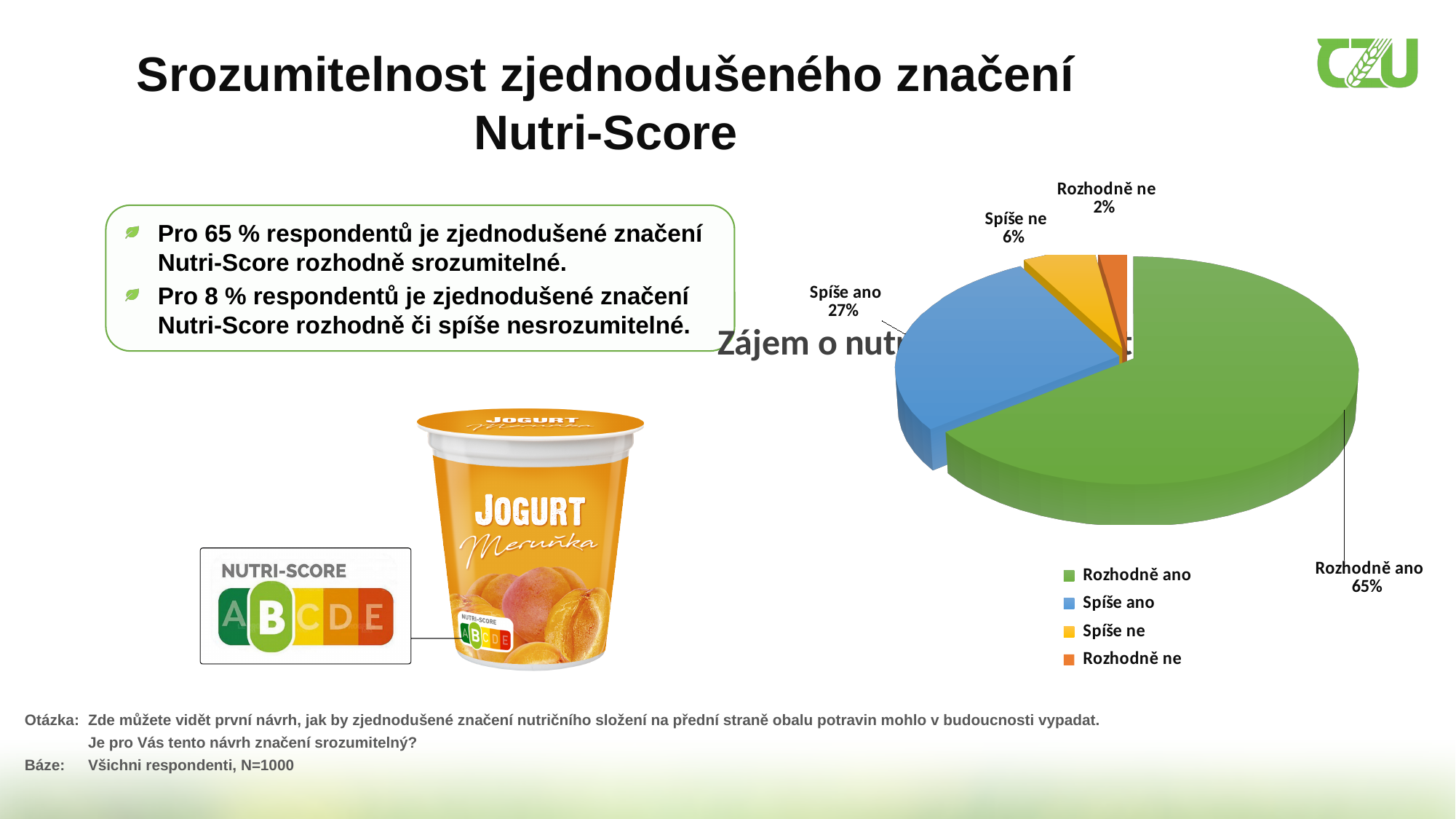
What share of respondents answered "Rozhodně ne" in the pie chart? 2% What share of respondents answered "Rozhodně ano" in the pie chart? 65% What is the difference in percentage points between "Rozhodně ano" and "Spíše ano" in the pie chart? 38 percentage points What colour is the "Spíše ano" slice in the pie chart? blue What share of respondents answered "Spíše ne" in the pie chart? 6% Which is larger in the pie chart, "Spíše ne" or "Rozhodně ne"? Spíše ne Which category has the smallest slice in the pie chart? Rozhodně ne What kind of chart is shown on the slide? pie chart How many slices does the pie chart have? 4 What share of respondents answered "Spíše ano" in the pie chart? 27% Which category has the largest slice in the pie chart? Rozhodně ano How many entries does the legend of the pie chart list? 4